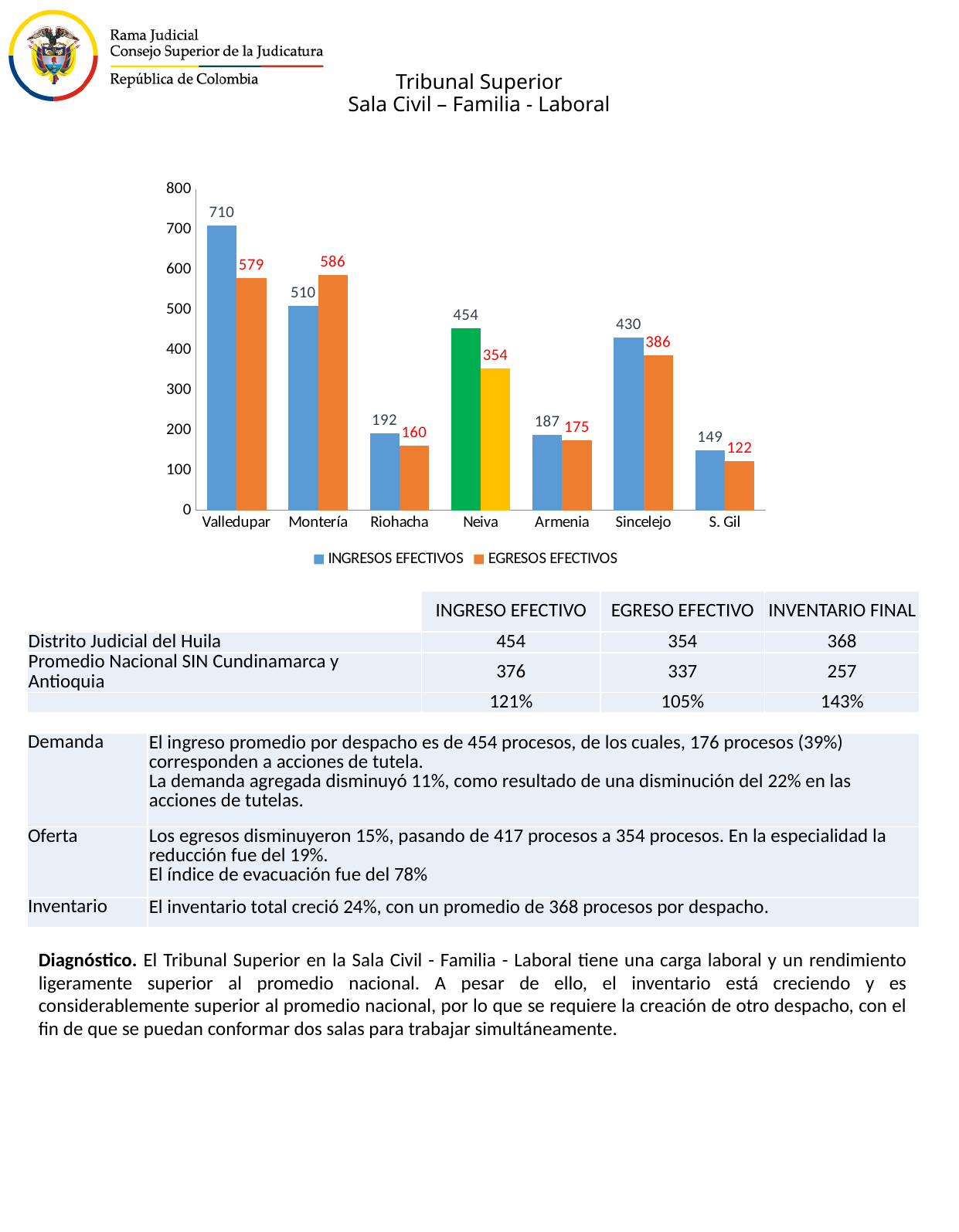
What is the difference between INGRESOS EFECTIVOS and EGRESOS EFECTIVOS for Valledupar? 131 Which city's bars are coloured differently (green and yellow) from the rest? Neiva Which is larger for Montería: INGRESOS EFECTIVOS or EGRESOS EFECTIVOS? EGRESOS EFECTIVOS What is the EGRESOS EFECTIVOS value for Montería? 586 Is the INGRESOS EFECTIVOS value for Sincelejo greater or less than 400? greater Which city has the highest INGRESOS EFECTIVOS value? Valledupar What kind of chart is shown on the slide? Bar chart What is the EGRESOS EFECTIVOS value for Neiva? 354 How many cities are shown on the x axis of the chart? 7 Which city has the lowest EGRESOS EFECTIVOS value? S. Gil What is the INGRESOS EFECTIVOS value for Valledupar? 710 How many series does the chart legend list? 2